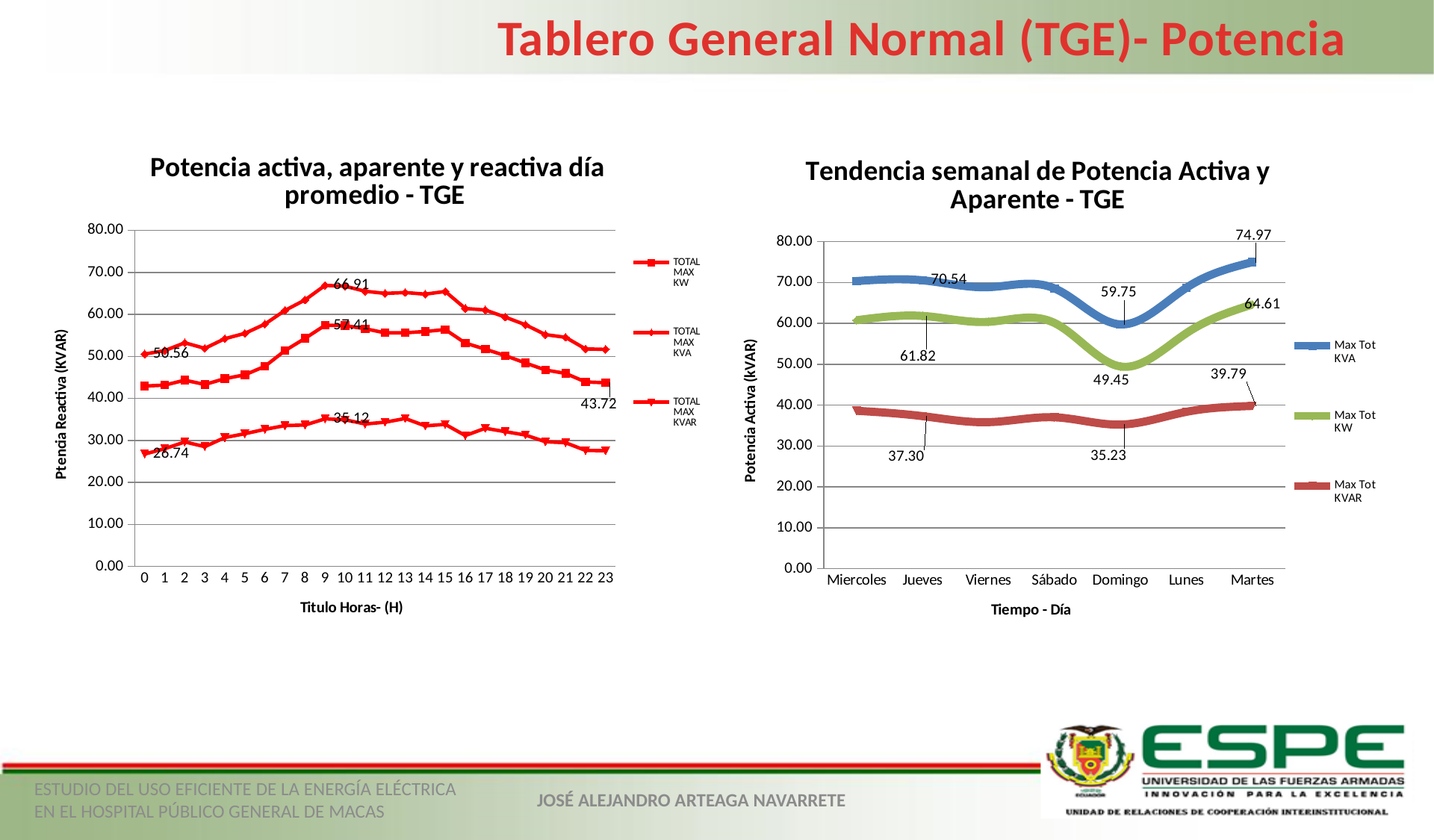
In the chart 'Potencia activa, aparente y reactiva día promedio - TGE', what is the TOTAL MAX KVAR value at hour 0? 26.74 In the chart 'Potencia activa, aparente y reactiva día promedio - TGE', what is the TOTAL MAX KVA value at hour 9? 66.91 In the chart 'Tendencia semanal de Potencia Activa y Aparente - TGE', what is the Max Tot KVA value on Martes? 74.97 In the chart 'Tendencia semanal de Potencia Activa y Aparente - TGE', what is the difference between Max Tot KVA and Max Tot KW on Martes? 10.36 How many series does the legend of the chart 'Tendencia semanal de Potencia Activa y Aparente - TGE' list? 3 What kind of chart is 'Potencia activa, aparente y reactiva día promedio - TGE'? Line chart In the chart 'Tendencia semanal de Potencia Activa y Aparente - TGE', which is larger: Max Tot KVA on Jueves or on Domingo? Jueves In the chart 'Potencia activa, aparente y reactiva día promedio - TGE', is the TOTAL MAX KVAR value at hour 15 greater or less than 40.00? less In the chart 'Tendencia semanal de Potencia Activa y Aparente - TGE', on which day is Max Tot KW lowest? Domingo In the chart 'Tendencia semanal de Potencia Activa y Aparente - TGE', what is the Max Tot KVAR value on Jueves? 37.30 How many days are shown on the x axis of the chart 'Tendencia semanal de Potencia Activa y Aparente - TGE'? 7 In the chart 'Tendencia semanal de Potencia Activa y Aparente - TGE', what is the Max Tot KW value on Domingo? 49.45